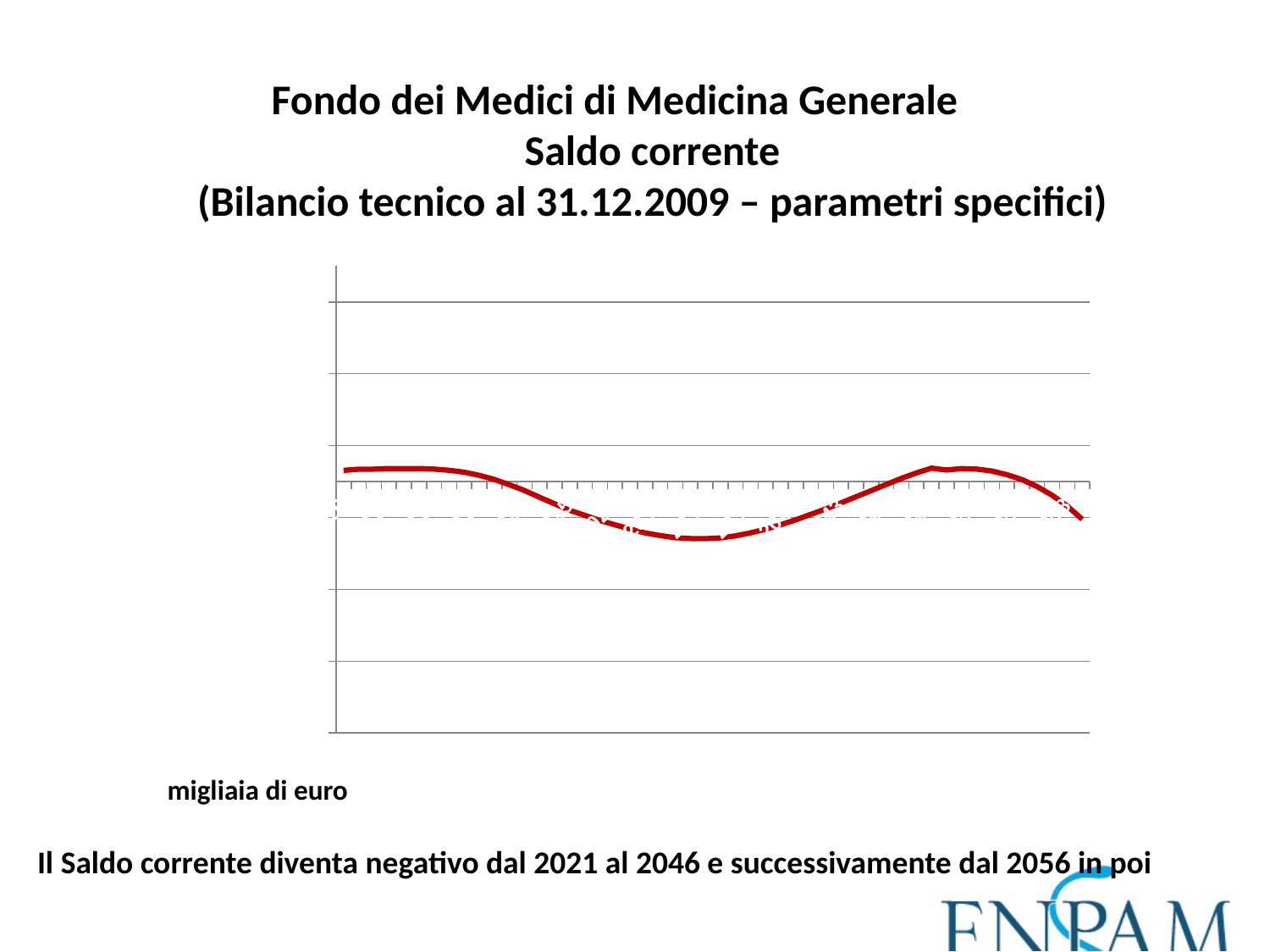
What unit of measure is indicated below the chart? migliaia di euro At the left-hand start of the chart, is the plotted line above or below the horizontal axis? above What colour is the line plotted on the chart? red Does the line rise or fall at the right-hand end of the chart? fall How many data series (lines) are plotted on the chart? 1 Does the line rise or fall immediately after its first dip below the horizontal axis, moving toward the right-hand peak? rise What kind of chart is shown on the slide? line chart